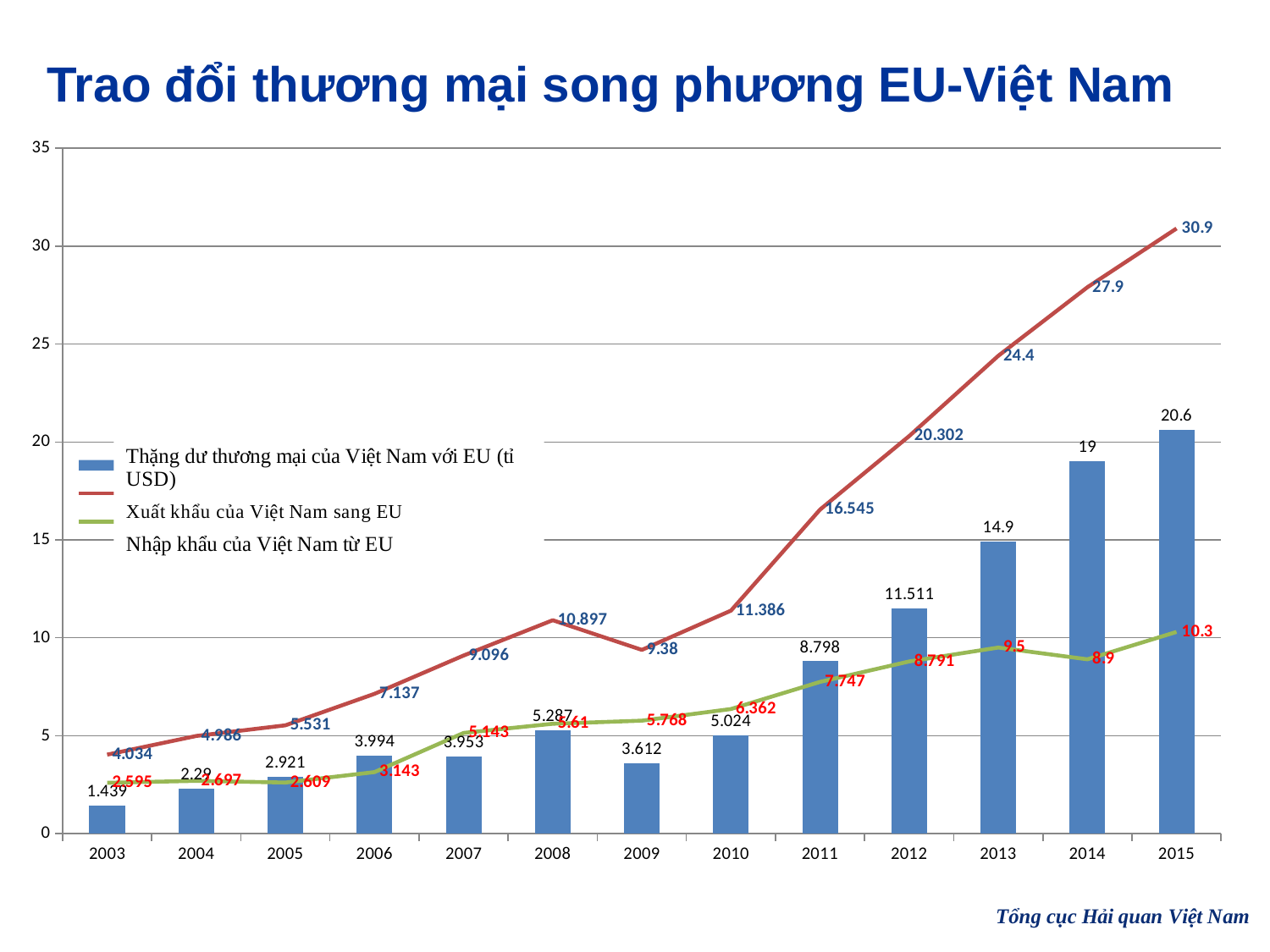
What is the value of Nhập khẩu của Việt Nam từ EU in 2007? 5.143 What is the difference between Xuất khẩu and Nhập khẩu in 2015? 20.6 What kind of chart is shown on the slide? Combined bar and line chart What is the value of the trade surplus bar (Thặng dư thương mại) for 2015? 20.6 Which is larger in 2009: the trade surplus bar or Nhập khẩu của Việt Nam từ EU? Nhập khẩu của Việt Nam từ EU What is the value of Xuất khẩu của Việt Nam sang EU in 2011? 16.545 In which year is the trade surplus bar the lowest? 2003 How many series does the legend list? 3 Is the value of Xuất khẩu của Việt Nam sang EU in 2013 greater or less than 25? less How many years are shown on the x axis? 13 By how much did the trade surplus bar increase from 2014 to 2015? 1.6 In which year does Xuất khẩu của Việt Nam sang EU reach its highest value? 2015